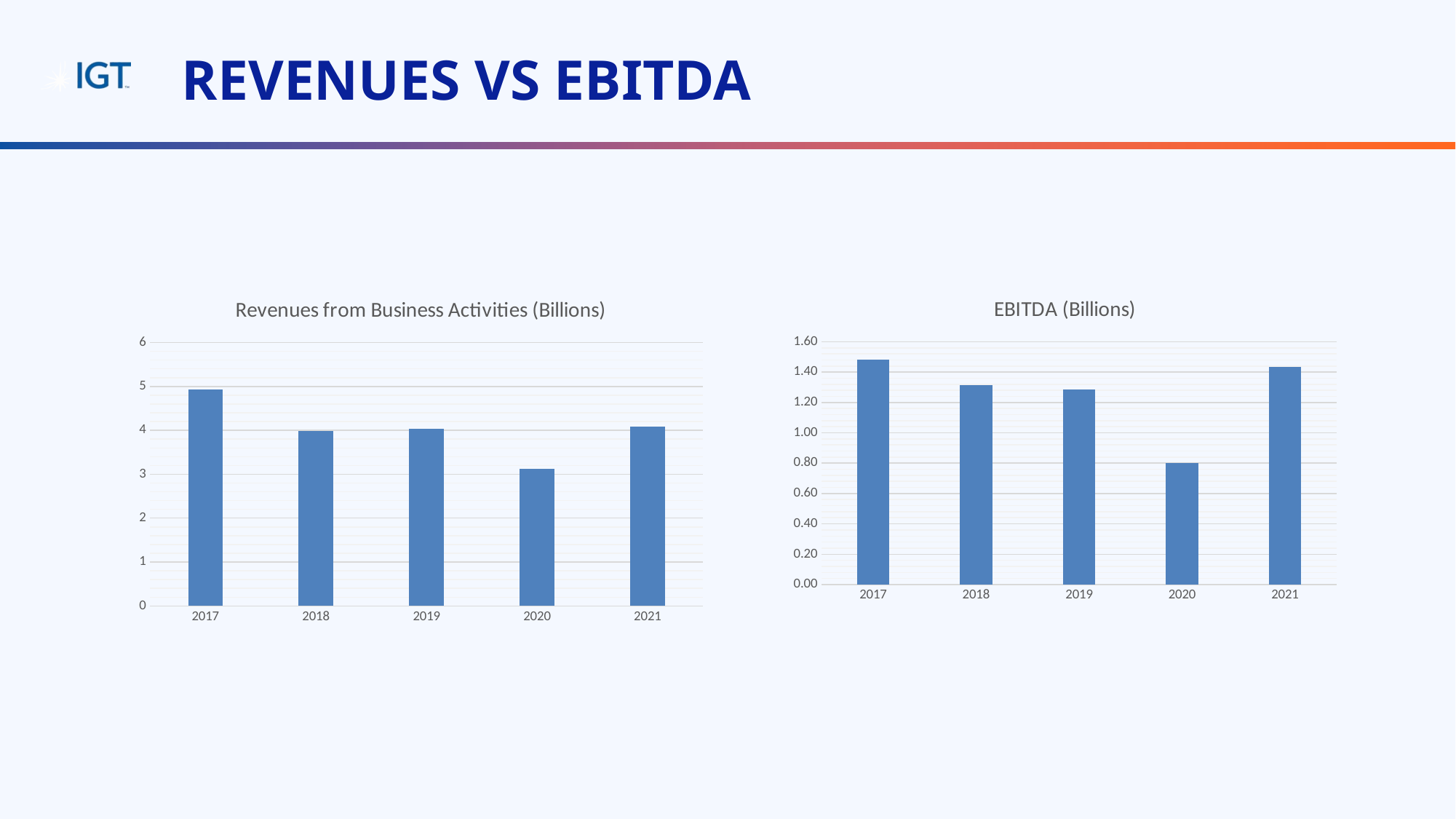
On the 'EBITDA (Billions)' chart, which year has the lowest EBITDA? 2020 On the 'Revenues from Business Activities (Billions)' chart, is the value for 2020 greater or less than 4? less On the 'EBITDA (Billions)' chart, is the value for 2020 greater or less than 1.00? less On the 'Revenues from Business Activities (Billions)' chart, which year has the highest revenue? 2017 How many years are shown on the 'EBITDA (Billions)' chart? 5 What is the title of the chart on the right side of the slide? EBITDA (Billions) On the 'Revenues from Business Activities (Billions)' chart, is the value for 2017 greater or less than 4? greater On the 'EBITDA (Billions)' chart, which year has the highest EBITDA? 2017 On the 'EBITDA (Billions)' chart, which is larger, the value for 2018 or the value for 2020? 2018 What type of chart is the 'Revenues from Business Activities (Billions)' chart? bar chart On the 'Revenues from Business Activities (Billions)' chart, which year has the lowest revenue? 2020